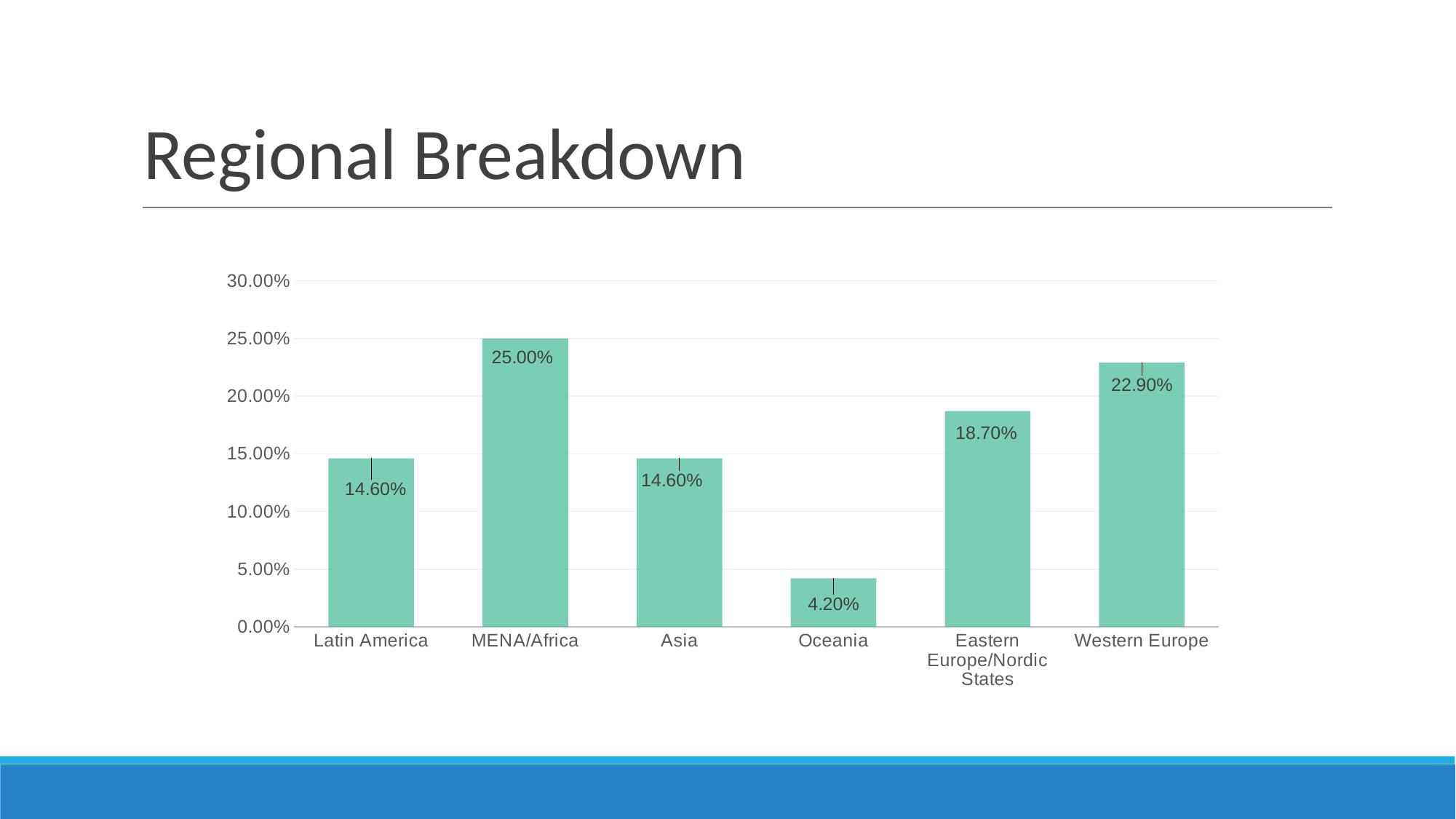
Which is larger, the value for Western Europe or the value for Eastern Europe/Nordic States? Western Europe How many regions are shown on the chart? 6 What is the value for Oceania? 4.20% What is the value for Western Europe? 22.90% What is the difference between the values for Eastern Europe/Nordic States and Oceania? 14.50% Which region has the lowest value? Oceania What is the value for Eastern Europe/Nordic States? 18.70% What is the difference between the values for MENA/Africa and Western Europe? 2.10% Which region has the highest value? MENA/Africa Is the value for Latin America greater or less than 10.00%? greater What is the value for MENA/Africa? 25.00% What kind of chart is shown on the slide? Bar chart